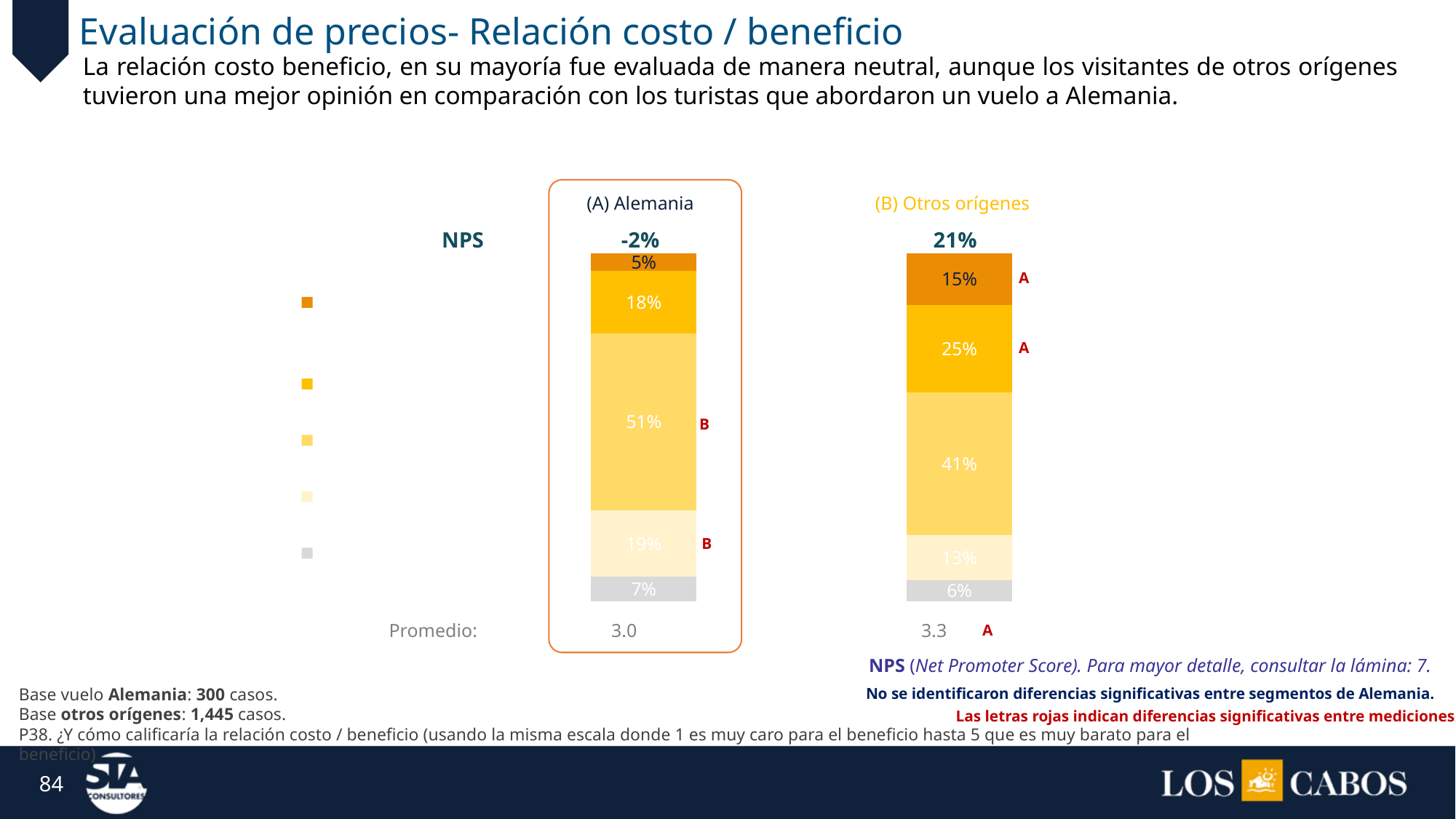
What is the value of the largest segment in the (A) Alemania bar? 51% Which group has the higher NPS, (A) Alemania or (B) Otros orígenes? (B) Otros orígenes What is the Promedio (average) shown for (A) Alemania? 3.0 What is the value of the top (dark orange) segment of the (B) Otros orígenes bar? 15% What kind of chart is shown on the slide? Stacked bar chart What is the NPS value shown for (A) Alemania? -2% What is the value of the largest segment in the (B) Otros orígenes bar? 41% What is the NPS value shown for (B) Otros orígenes? 21% How many stacked bars are shown in the chart? 2 What is the Promedio (average) shown for (B) Otros orígenes? 3.3 What is the value of the bottom (grey) segment of the (A) Alemania bar? 7% What is the difference between the largest segment of the (A) Alemania bar (51%) and the largest segment of the (B) Otros orígenes bar (41%)? 10 percentage points